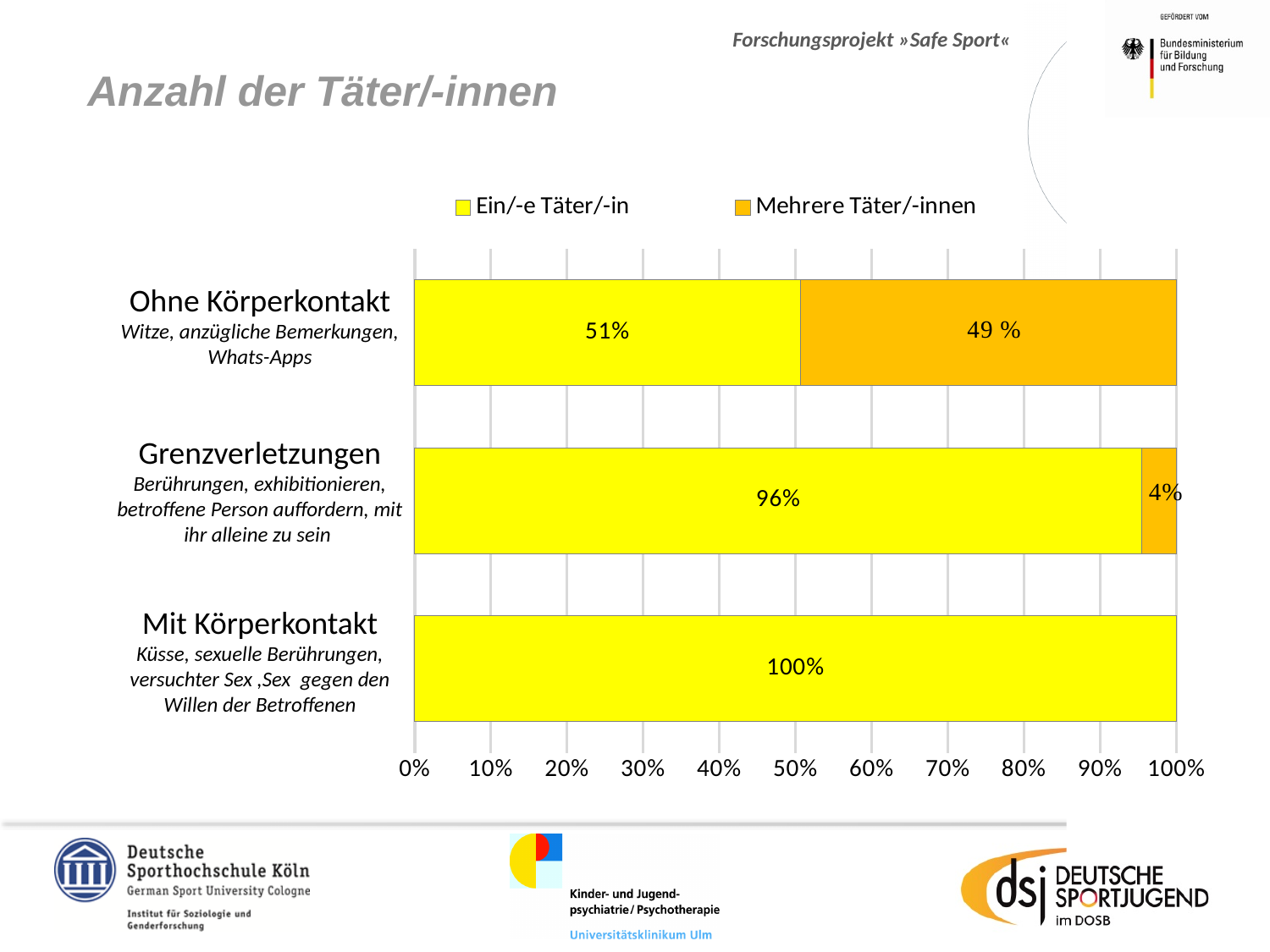
What is the value for "Mehrere Täter/-innen" in the "Ohne Körperkontakt" category? 49 % Which category has the highest value for "Ein/-e Täter/-in"? Mit Körperkontakt What kind of chart is shown on the slide? Stacked bar chart What is the value for "Mehrere Täter/-innen" in the "Grenzverletzungen" category? 4% How many series does the legend list? 2 What is the difference between the "Ein/-e Täter/-in" values for "Grenzverletzungen" and "Ohne Körperkontakt"? 45 percentage points What is the value for "Ein/-e Täter/-in" in the "Grenzverletzungen" category? 96% How many categories are shown on the chart? 3 What is the value for "Ein/-e Täter/-in" in the "Ohne Körperkontakt" category? 51% Which is larger in the "Ohne Körperkontakt" category: "Ein/-e Täter/-in" or "Mehrere Täter/-innen"? Ein/-e Täter/-in What is the value for "Ein/-e Täter/-in" in the "Mit Körperkontakt" category? 100% Which category has the lowest value for "Ein/-e Täter/-in"? Ohne Körperkontakt